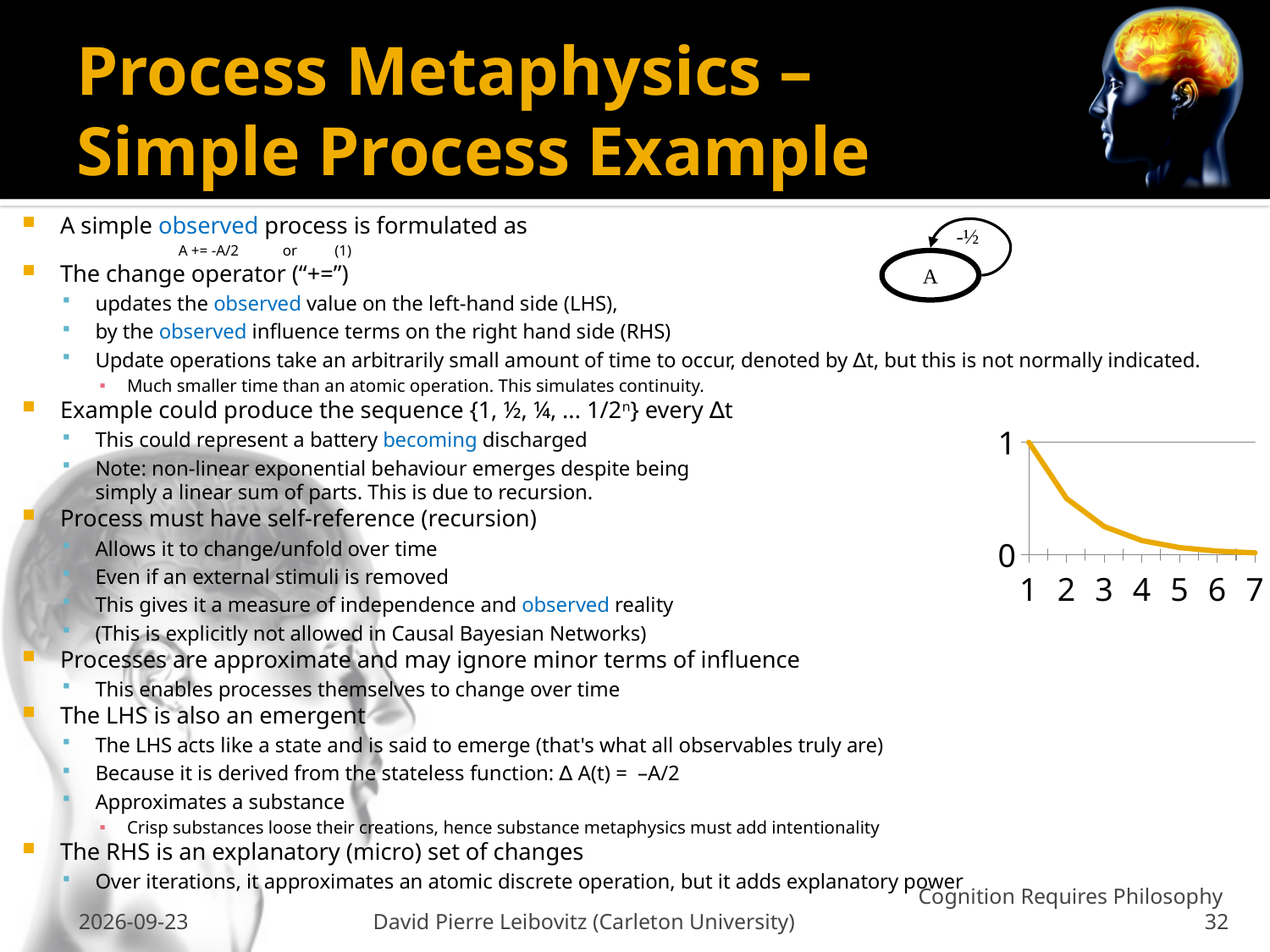
What colour is the plotted line in the line chart? orange In the line chart, which is larger: the value at x = 2 or the value at x = 5? x = 2 In the line chart, do the values rise or fall as the x axis goes from 1 to 7? fall What kind of chart is shown at the right of the slide? line chart What are the two tick labels shown on the y axis of the line chart? 0 and 1 In the line chart, which is larger: the value at x = 1 or the value at x = 7? x = 1 In the line chart, what is the value at x = 1? 1 How many labelled points are there along the x axis of the line chart? 7 In the line chart, is the value at x = 2 greater or less than 1? less In the line chart, at which x value is the plotted value highest? 1 In the line chart, is the value at x = 4 greater or less than 1? less